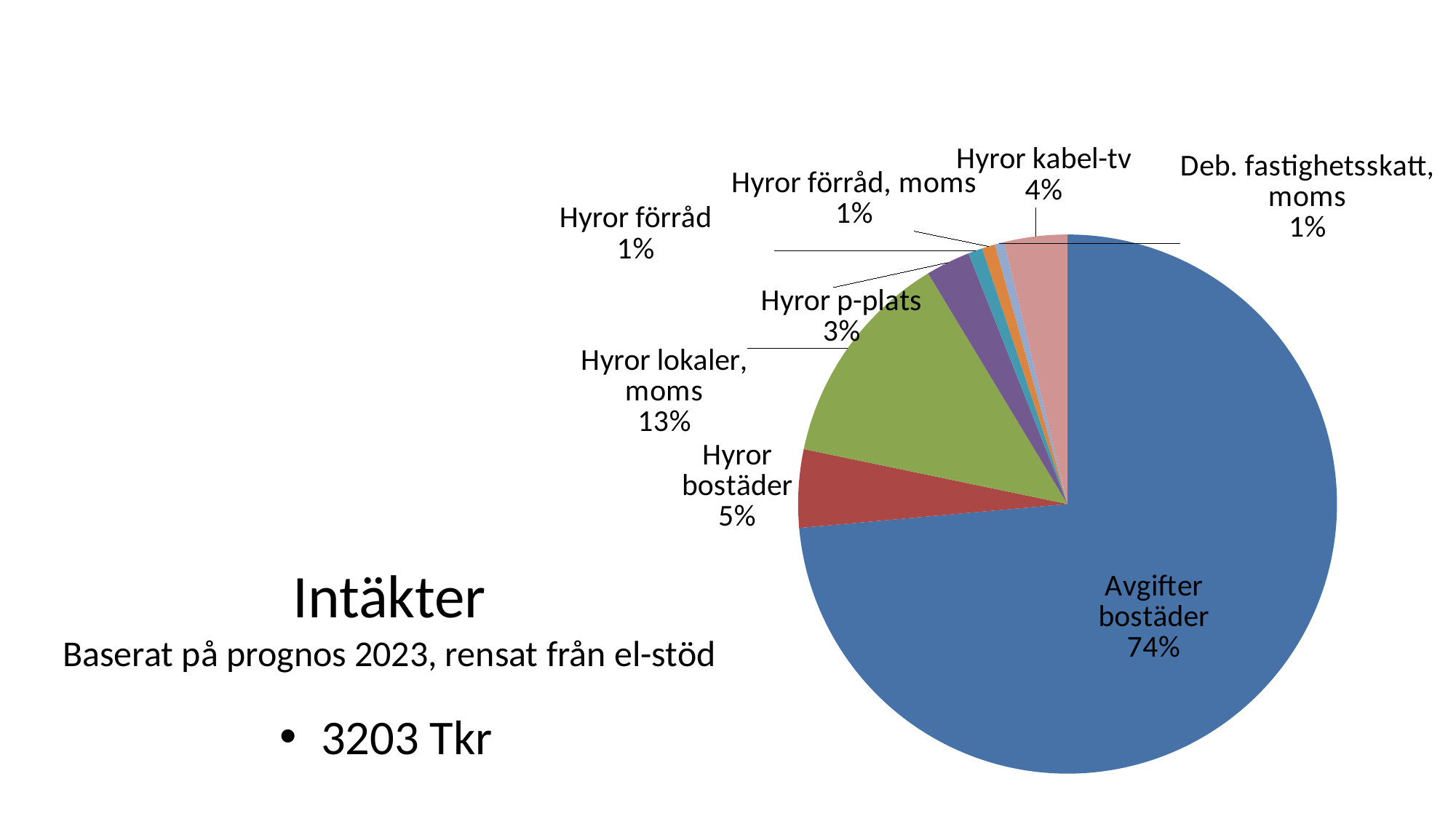
What share of the pie does Hyror p-plats represent? 3% What is the difference in percentage points between Avgifter bostäder and Hyror lokaler, moms? 61 What share of the pie does Hyror lokaler, moms represent? 13% How many slices does the pie chart have? 8 What share of the pie does Hyror kabel-tv represent? 4% Which category has the largest slice of the pie? Avgifter bostäder What is the title of the chart? Intäkter What kind of chart is shown on the slide? Pie chart What total amount in Tkr is stated on the slide? 3203 Tkr Which is larger, the slice for Hyror lokaler, moms or the slice for Hyror bostäder? Hyror lokaler, moms